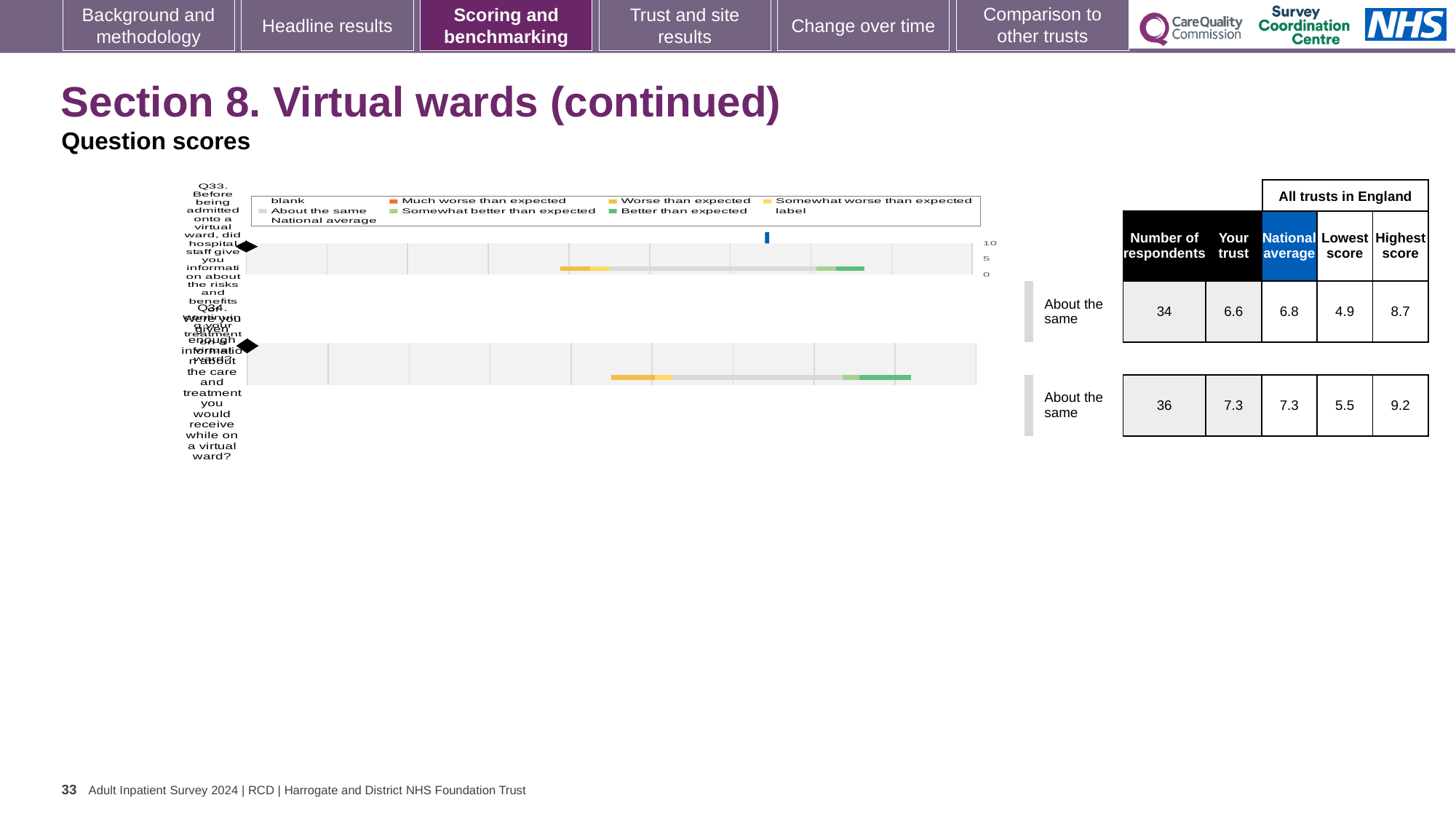
Which question has the higher 'Your trust' score, Q33 or Q34? Q34 How many respondents answered Q33? 34 What is the highest score among all trusts in England for Q34? 9.2 What kind of chart is shown on the slide? bar chart What colour does the legend use for 'Better than expected'? green What is the benchmark category shown for Q34? About the same What is the national average score for Q34? 7.3 What is the lowest score among all trusts in England for Q33? 4.9 How many questions (bars) are plotted in the chart? 2 What is the 'Your trust' score for Q33? 6.6 What is the difference between the highest and lowest scores for Q33? 3.8 What colour does the legend use for 'Much worse than expected'? orange